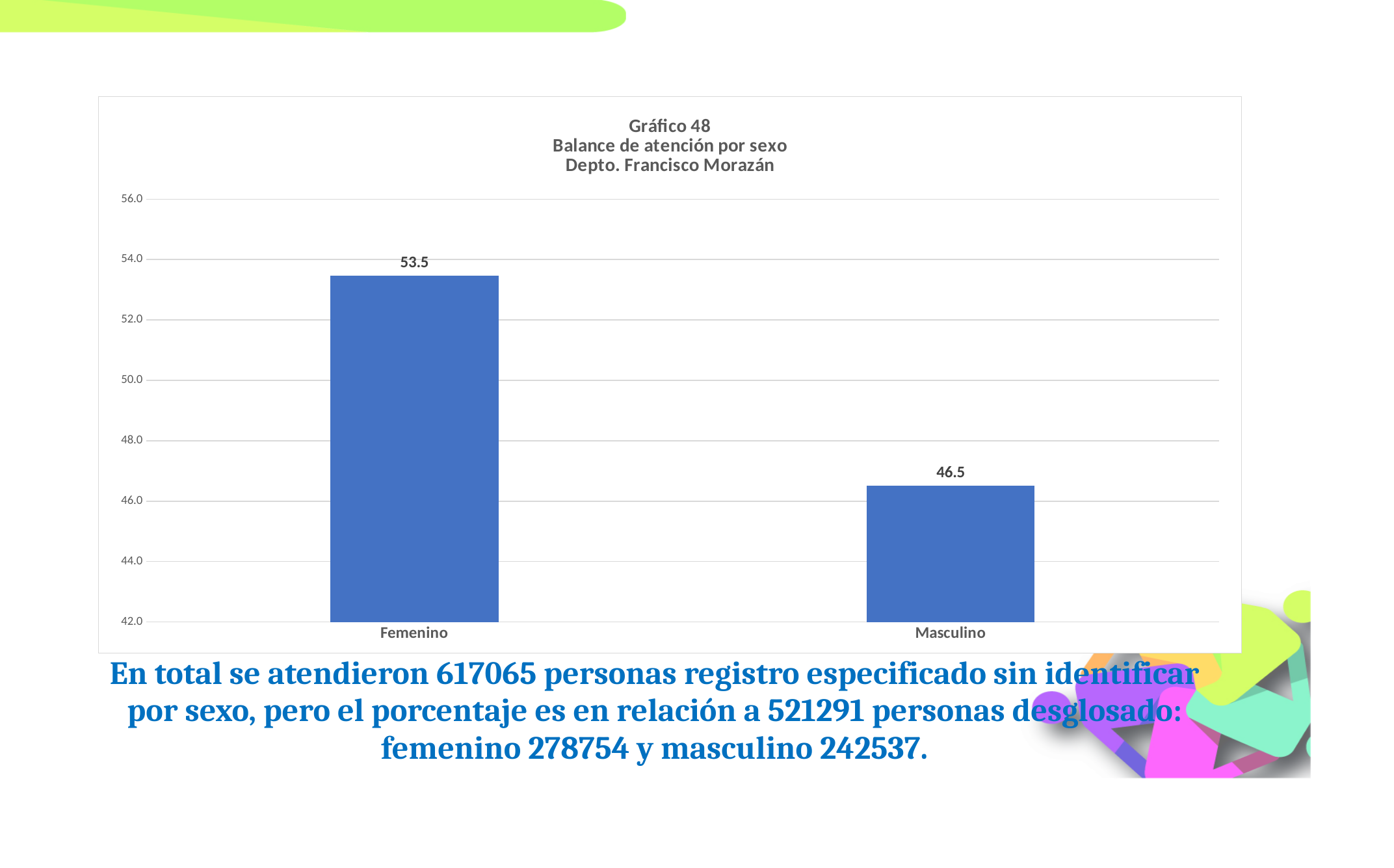
Which is larger, the value for Femenino or the value for Masculino? Femenino Which category has the highest value? Femenino Which category has the lowest value? Masculino What is the difference between the values for Femenino and Masculino? 7.0 What is the value for Masculino? 46.5 How many categories are shown on the x axis? 2 What kind of chart is shown on the slide? bar chart What is the lowest value shown on the y axis? 42.0 What is the title of the chart? Gráfico 48 Balance de atención por sexo Depto. Francisco Morazán What is the value for Femenino? 53.5 Is the value for Masculino greater or less than 48.0? less Is the value for Femenino greater or less than 52.0? greater